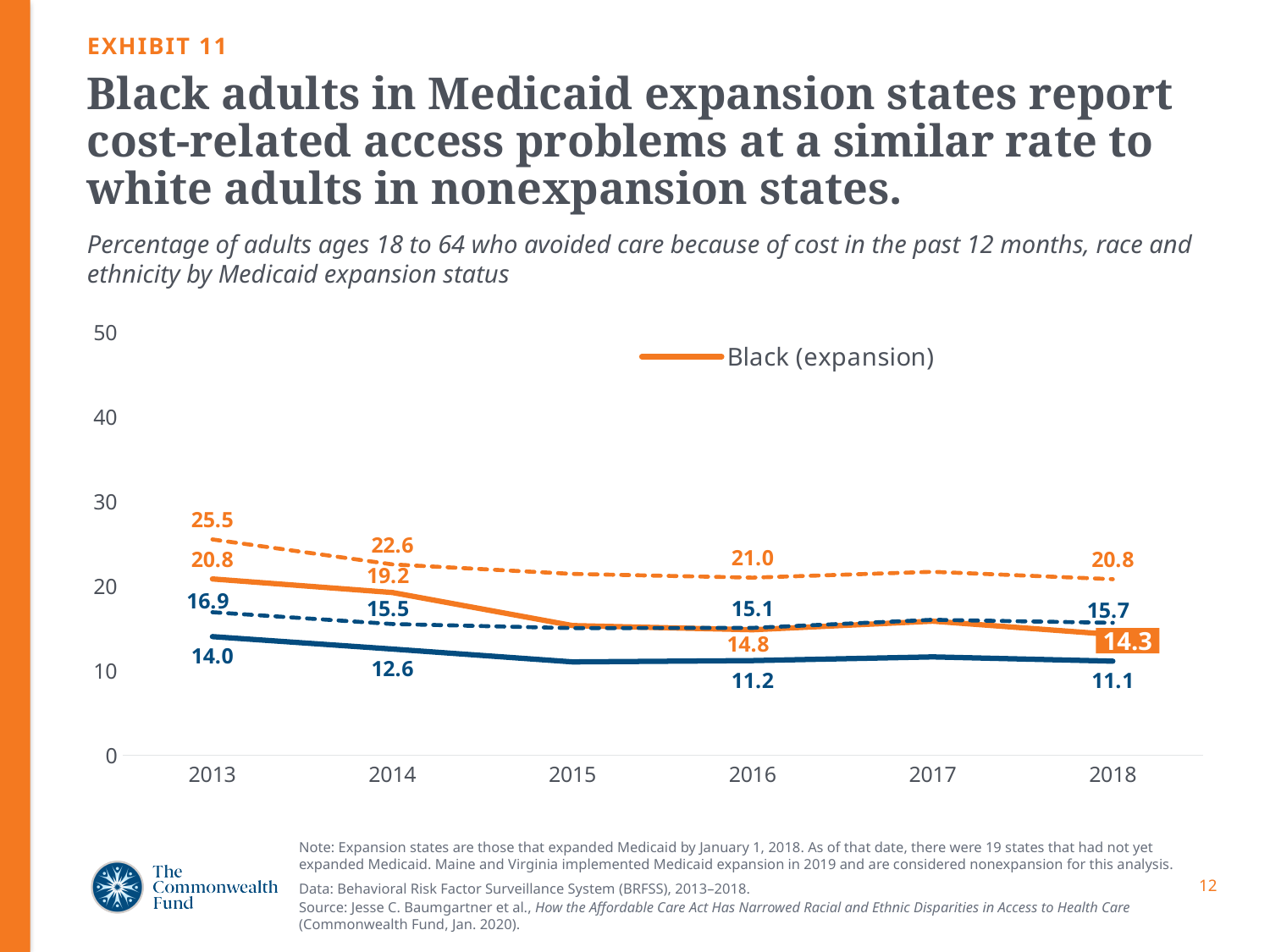
What is the value for Black (expansion) in 2013? 20.8 What is the value for Black (expansion) in 2016? 14.8 By how much did the Black (expansion) value change from 2013 to 2018? 6.5 What is the exhibit number shown above the chart title? Exhibit 11 How many series does the legend list? 1 What kind of chart is shown on the slide? line chart What is the value for Black (expansion) in 2014? 19.2 Is the value for Black (expansion) in 2015 greater or less than 20? less Which is larger for Black (expansion): the 2014 value or the 2016 value? 2014 How many years are shown on the x axis? 6 Does the Black (expansion) line generally rise or fall from 2013 to 2018? fall What is the value for Black (expansion) in 2018? 14.3